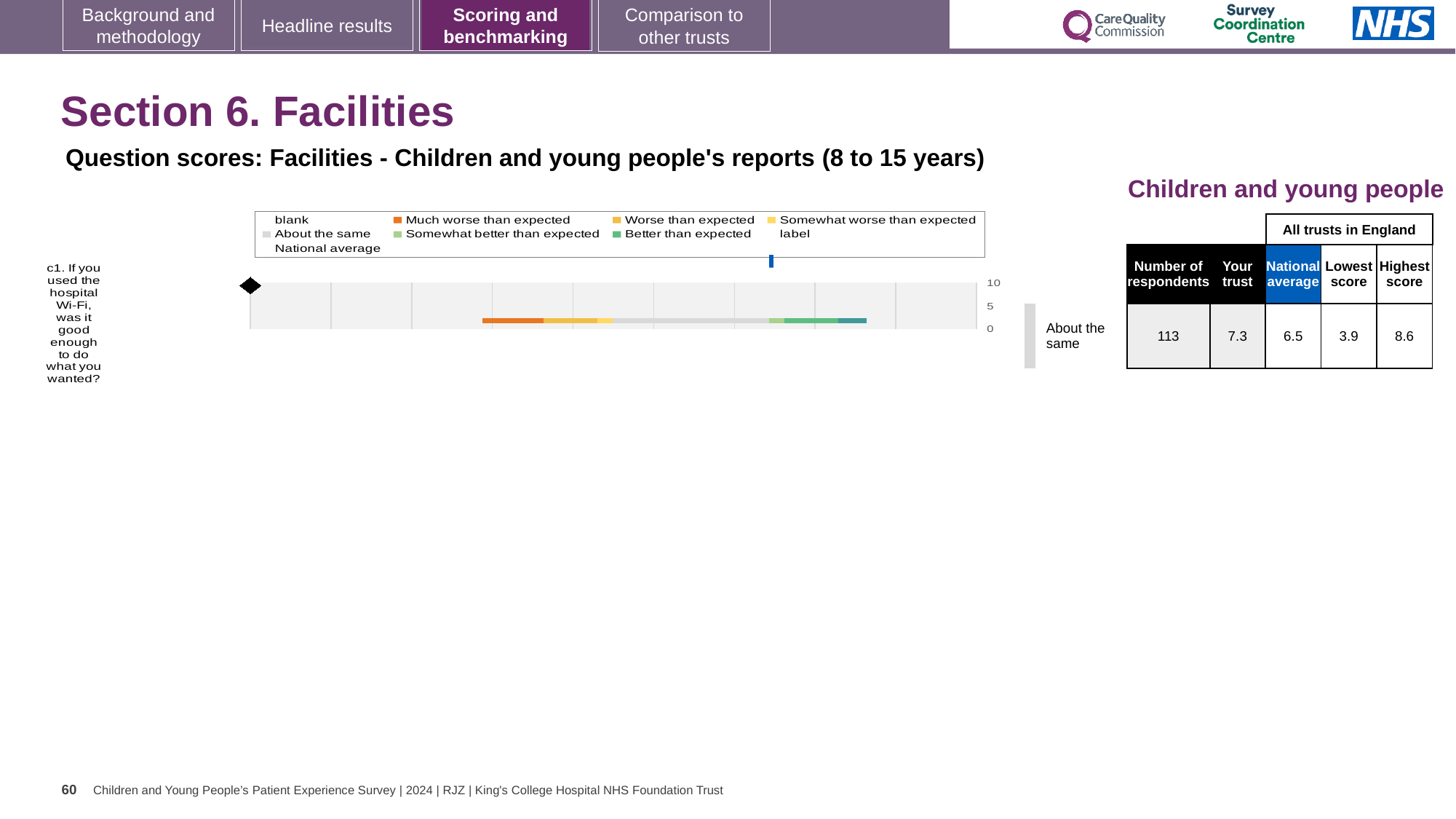
What is the highest value shown on the chart's score axis? 10 How many survey questions are plotted in the chart on this slide? 1 For question c1, which is larger: the 'Your trust' score or the national average? Your trust What is the highest score among all trusts in England for question c1? 8.6 What is the 'Your trust' score for question c1 about hospital Wi-Fi? 7.3 Which survey question is plotted in the chart on this slide? c1. If you used the hospital Wi-Fi, was it good enough to do what you wanted? What is the national average score for question c1 about hospital Wi-Fi? 6.5 What kind of chart is used to show the question score for c1 on this slide? bar chart How many respondents answered question c1 about hospital Wi-Fi? 113 Which benchmarking category is the trust's score for question c1 assigned to? About the same For question c1, what is the difference between the highest score and the lowest score among all trusts in England? 4.7 What is the lowest score among all trusts in England for question c1? 3.9